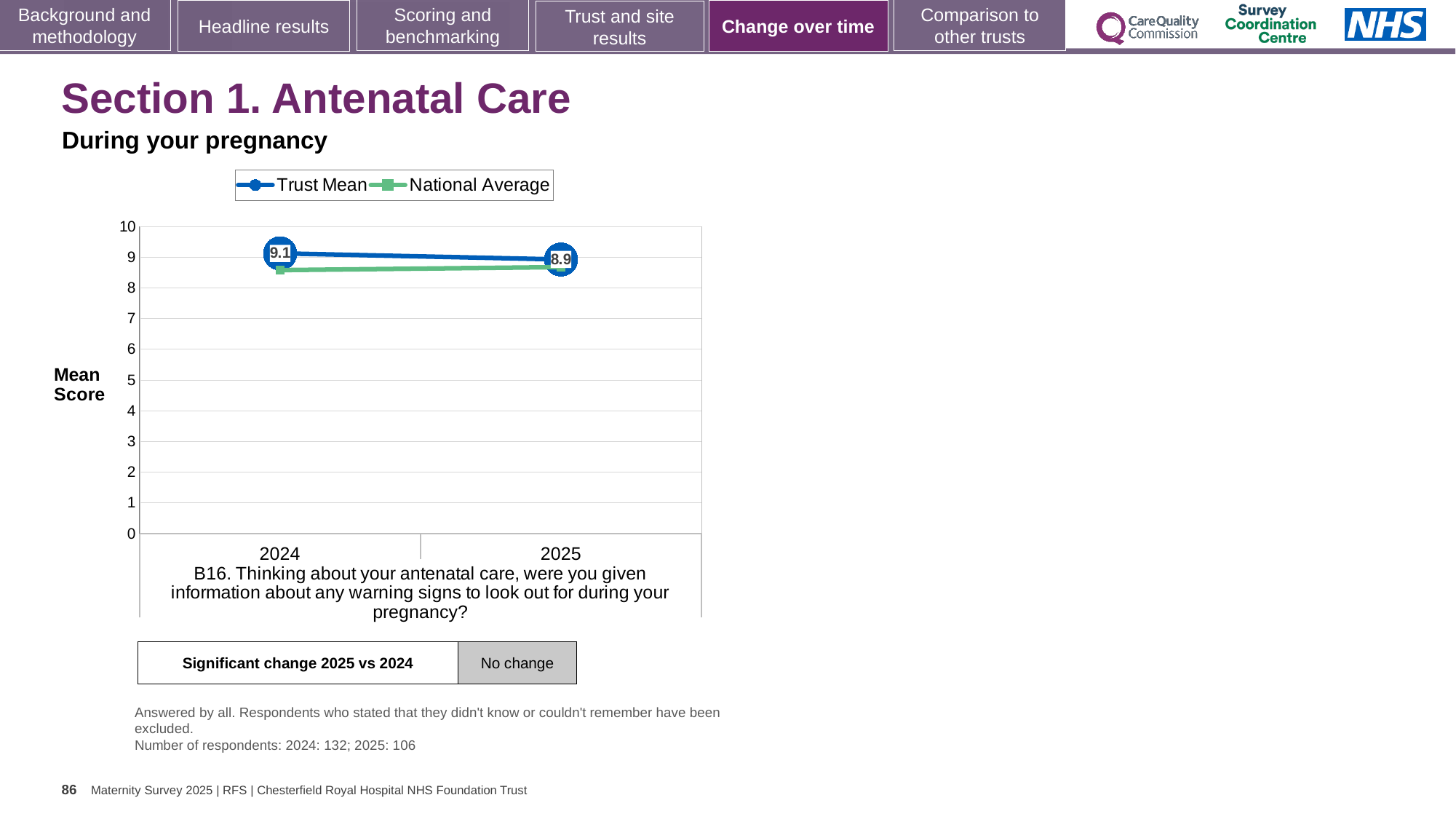
What type of chart is shown on the slide? line chart In which year is the Trust Mean score lowest? 2025 What is the difference between the Trust Mean score in 2024 and in 2025? 0.2 Is the National Average value for 2024 greater or less than 9? less What is the Trust Mean score for 2025? 8.9 How many series does the legend list? 2 Does the Trust Mean rise or fall from 2024 to 2025? fall What is the Trust Mean score for 2024? 9.1 In 2024, which is larger: the Trust Mean or the National Average? Trust Mean In which year is the Trust Mean score highest? 2024 How many years are plotted on the x axis? 2 Is the National Average value for 2024 greater or less than 8? greater